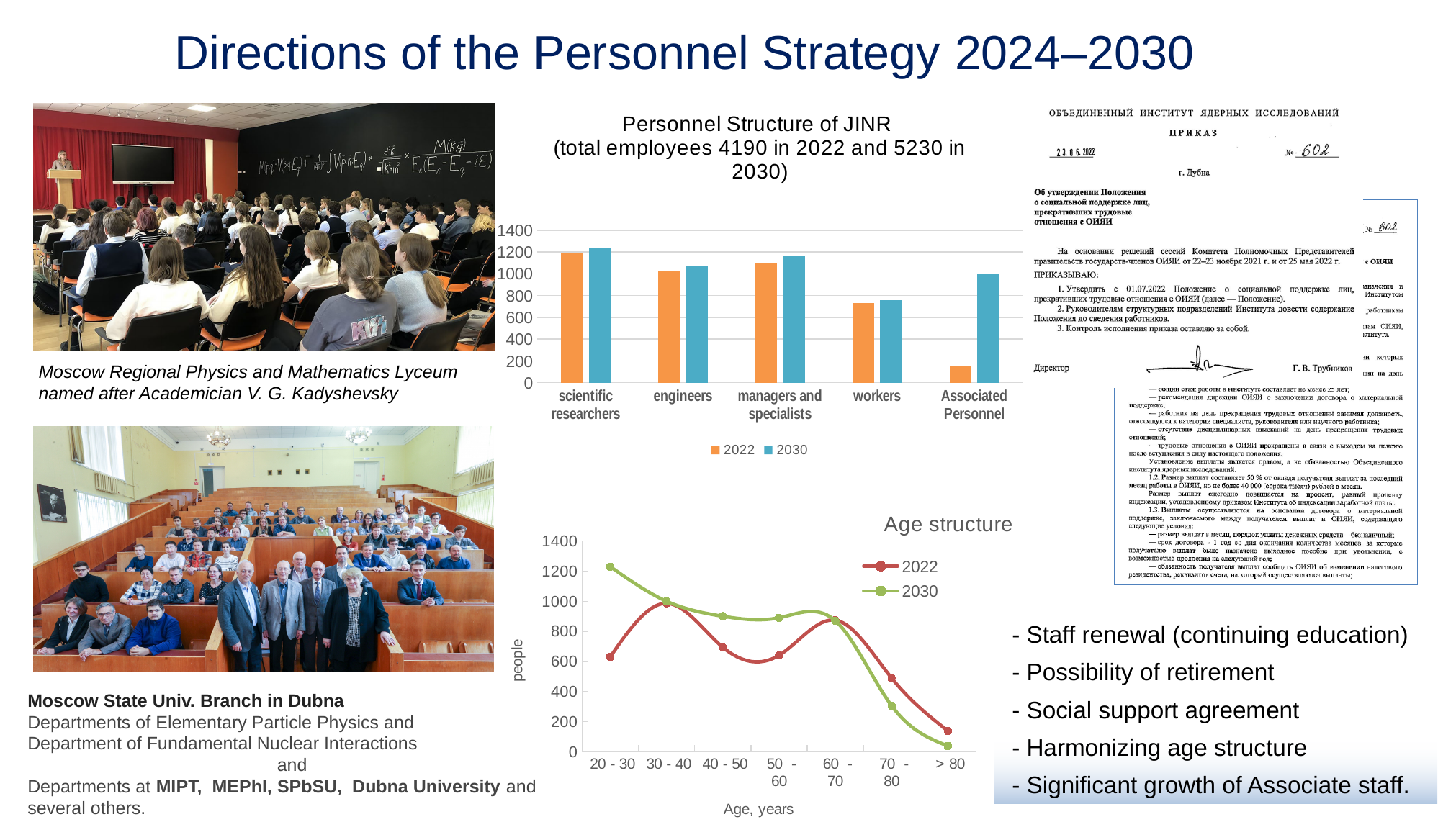
In the 'Age structure' chart, how many age groups are shown on the x axis? 7 What kind of chart is the 'Age structure' chart? line chart In the 'Personnel Structure of JINR' chart, how many series does the legend list? 2 In the 'Age structure' chart, which age group has the highest value for 2030? 20 - 30 In the 'Personnel Structure of JINR' chart, is the 2022 value for Associated Personnel greater or less than 400? less What kind of chart is the 'Personnel Structure of JINR' chart? bar chart In the 'Personnel Structure of JINR' chart, which category has the lowest value for 2022? Associated Personnel In the 'Age structure' chart, is the 2022 value for the > 80 age group greater or less than 400? less In the 'Personnel Structure of JINR' chart, how many personnel categories are shown on the x axis? 5 In the 'Personnel Structure of JINR' chart, which is larger for Associated Personnel: the 2022 value or the 2030 value? 2030 In the 'Personnel Structure of JINR' chart, is the 2030 value for workers greater or less than 1000? less In the 'Personnel Structure of JINR' chart, which category has the highest value for 2030? scientific researchers